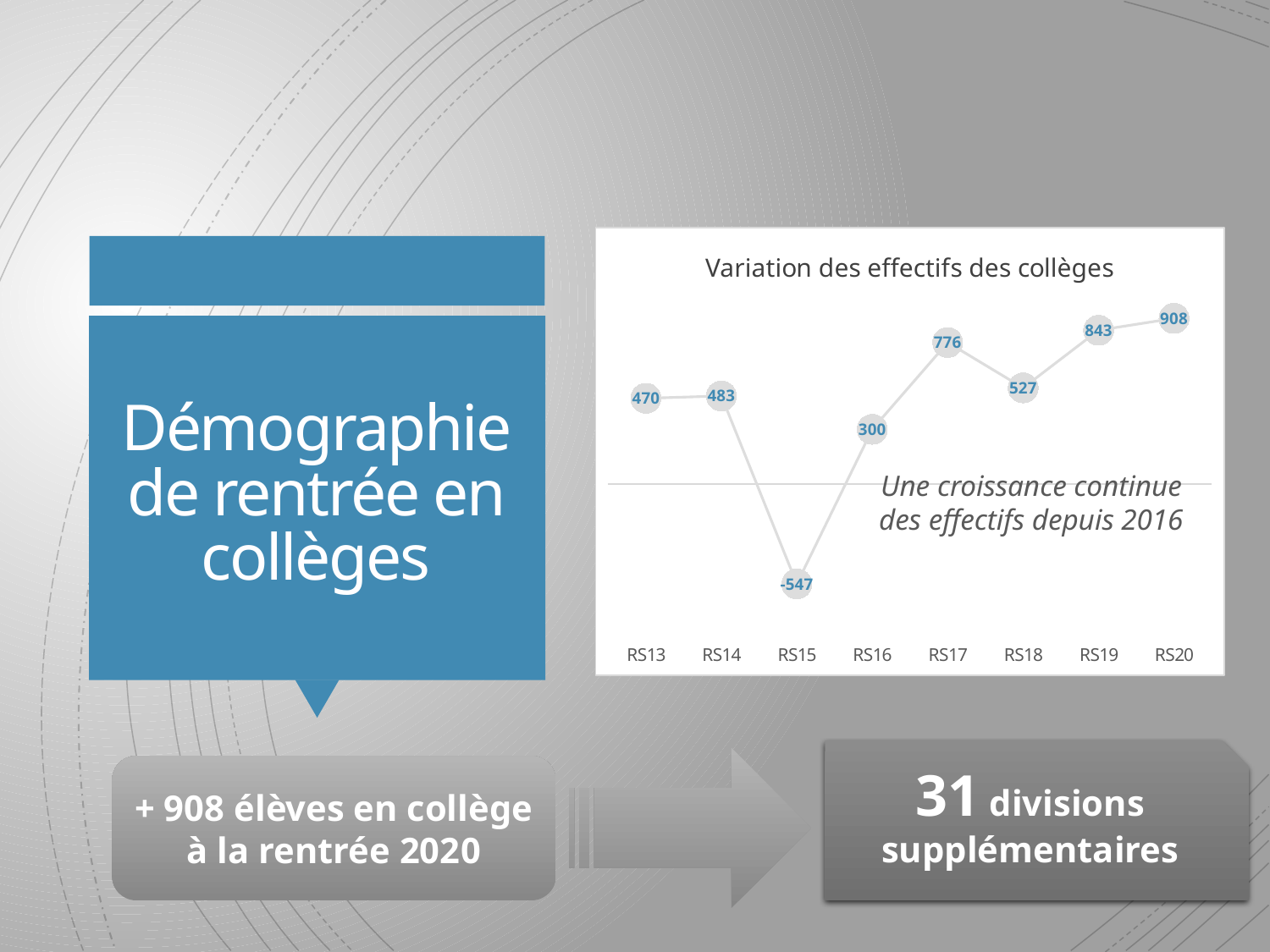
What is the value for RS13 in the chart? 470 What is the difference between the values for RS17 and RS18? 249 What is the value for RS15 in the chart? -547 What is the value for RS20 in the chart? 908 What kind of chart is shown on the slide? Line chart What is the title of the chart? Variation des effectifs des collèges What is the value for RS17 in the chart? 776 Which is larger, the value for RS14 or the value for RS16? RS14 What is the difference between the values for RS20 and RS19? 65 How many data points are plotted in the chart? 8 Which category has the lowest value in the chart? RS15 Which category has the highest value in the chart? RS20